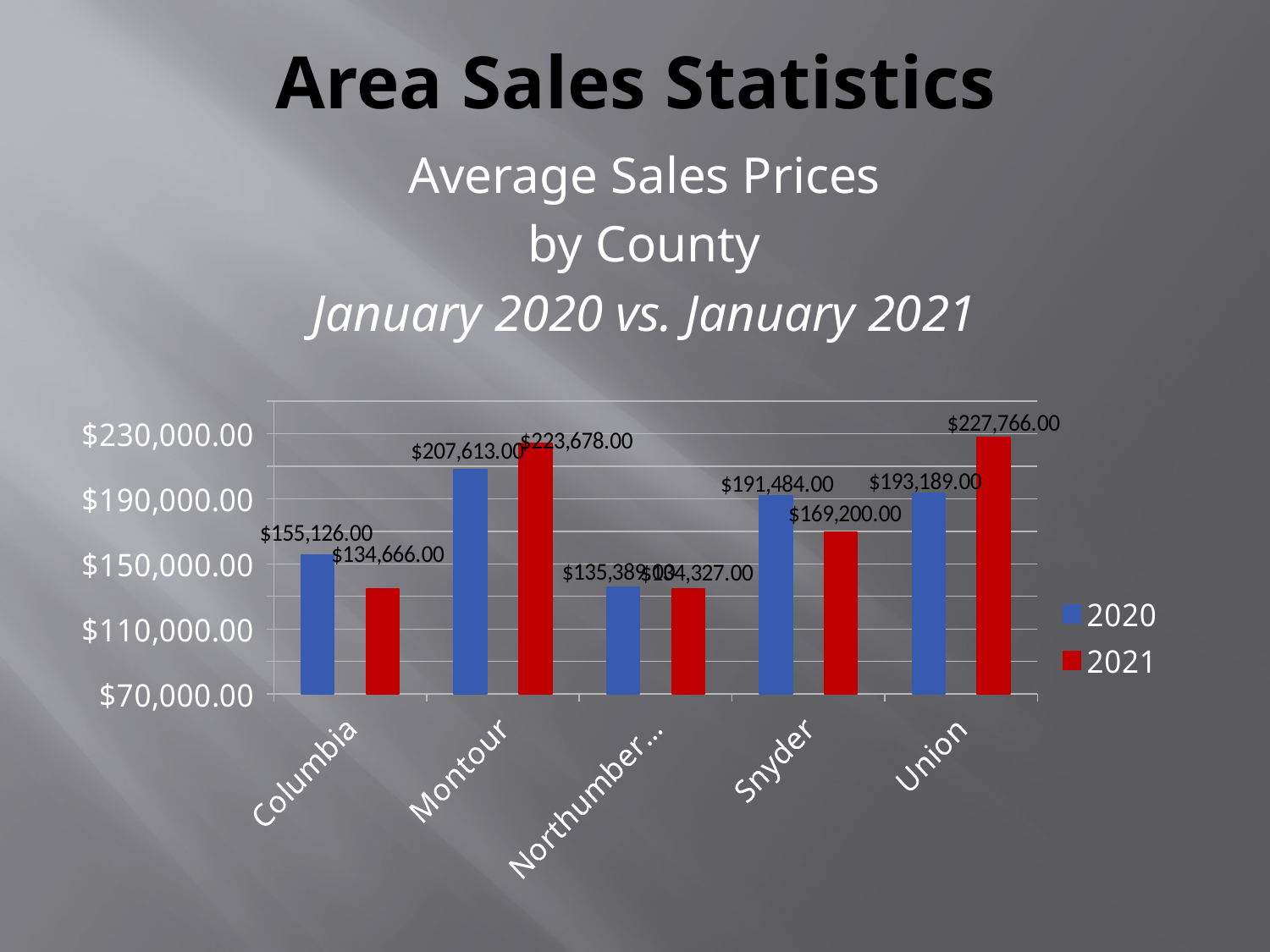
What was the average sales price in Union County in 2021? $227,766.00 What was the average sales price in Columbia County in 2020? $155,126.00 Which county had the highest average sales price in 2020? Montour What was the average sales price in Snyder County in 2021? $169,200.00 By how much did the average sales price in Columbia County fall from 2020 to 2021? $20,460.00 In Snyder County, which year had the higher average sales price, 2020 or 2021? 2020 By how much did the average sales price in Union County rise from 2020 to 2021? $34,577.00 How many counties are shown on the x axis of the chart? 5 How many series does the legend list? 2 What was the average sales price in Montour County in 2021? $223,678.00 What kind of chart is shown on the slide? Bar chart Which county had the highest average sales price in 2021? Union